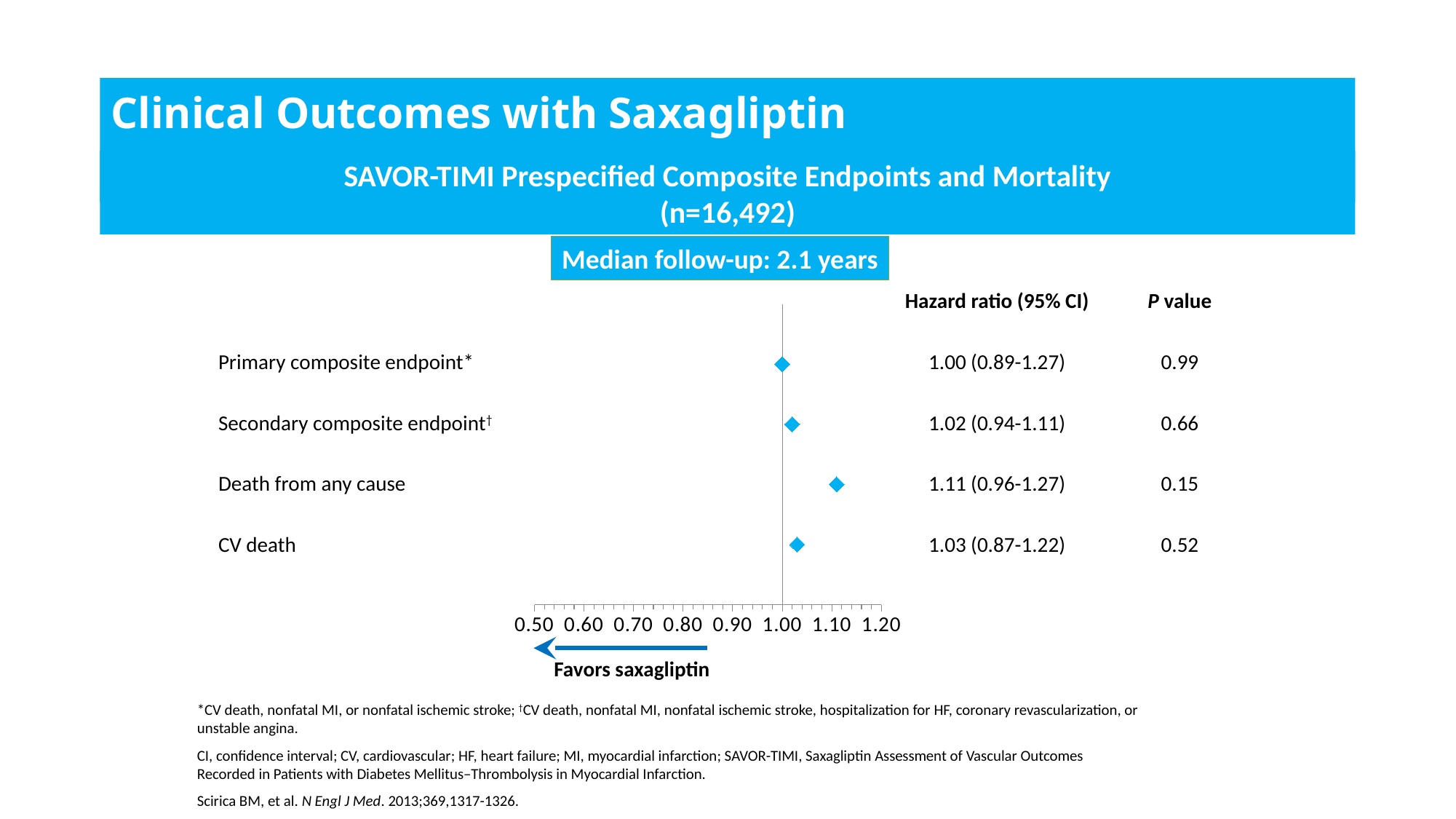
What is the difference between the hazard ratio for Death from any cause and the hazard ratio for the Primary composite endpoint? 0.11 What is the 95% CI for the Primary composite endpoint? 0.89-1.27 What is the median follow-up stated on the slide? 2.1 years How many outcomes are plotted in the chart? 4 What kind of chart is shown on the slide? forest plot What is the P value for the Secondary composite endpoint? 0.66 Which outcome has the highest hazard ratio? Death from any cause What is the hazard ratio for CV death? 1.03 Which has the larger hazard ratio, CV death or the Secondary composite endpoint? CV death Is the hazard ratio for Death from any cause greater or less than 1.00? greater What is the hazard ratio for Death from any cause? 1.11 Which outcome has the lowest hazard ratio? Primary composite endpoint